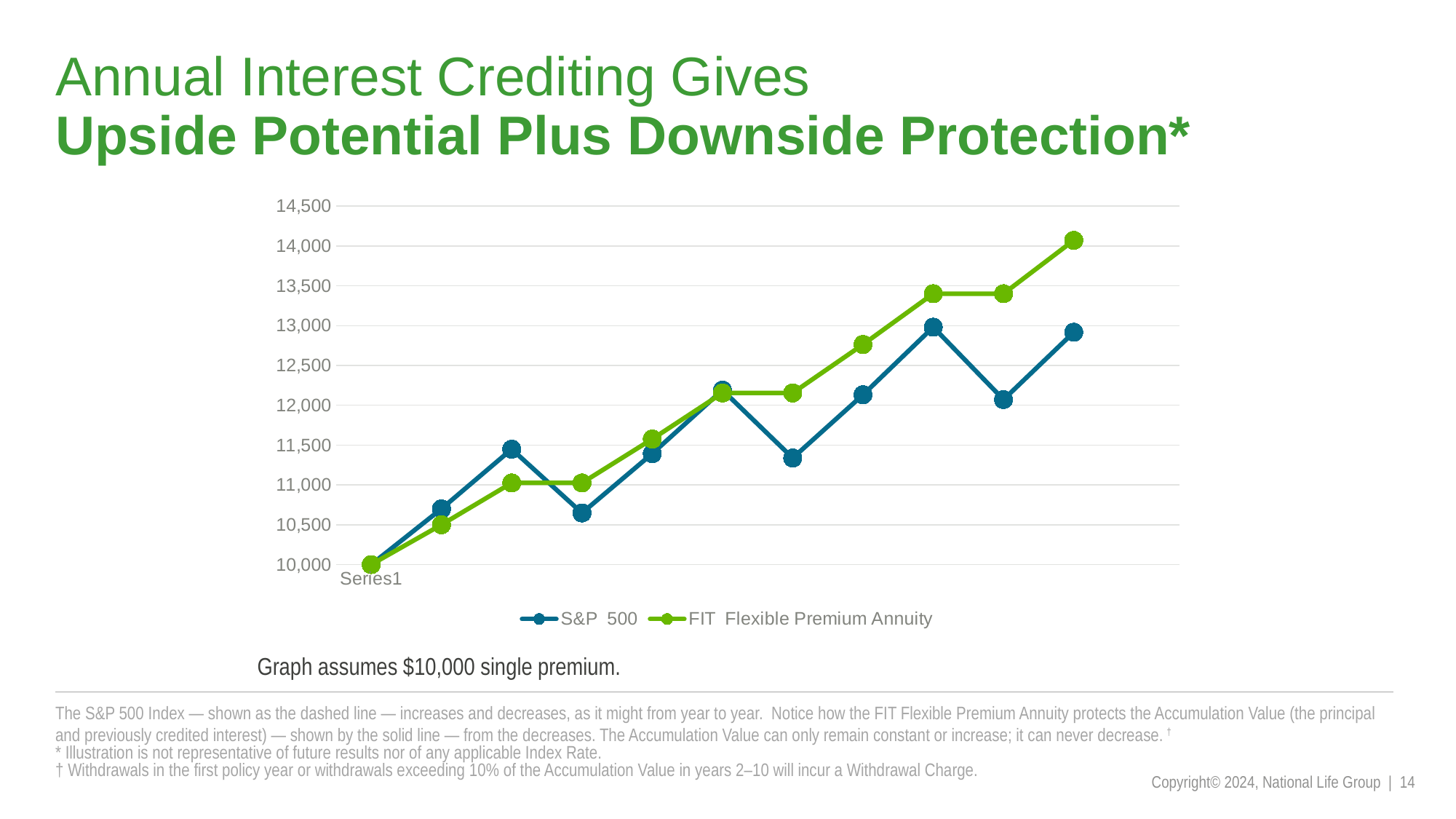
Is the final value of the FIT Flexible Premium Annuity line greater or less than 13,500? greater What colour is the S&P 500 line in the chart? Blue What are the two series named in the chart legend? S&P 500 and FIT Flexible Premium Annuity Which series reaches the highest value on the chart? FIT Flexible Premium Annuity Does the FIT Flexible Premium Annuity line ever decrease from one point to the next? No What value do both lines start at on the left of the chart? 10,000 Does the S&P 500 line rise steadily, or does it rise and fall along the x axis? It rises and falls What kind of chart is shown on the slide? Line chart At the final point on the right, which series is higher: S&P 500 or FIT Flexible Premium Annuity? FIT Flexible Premium Annuity How many series does the chart legend list? 2 Is the final value of the S&P 500 line greater or less than 13,500? less How many data points does each line in the chart have? 11